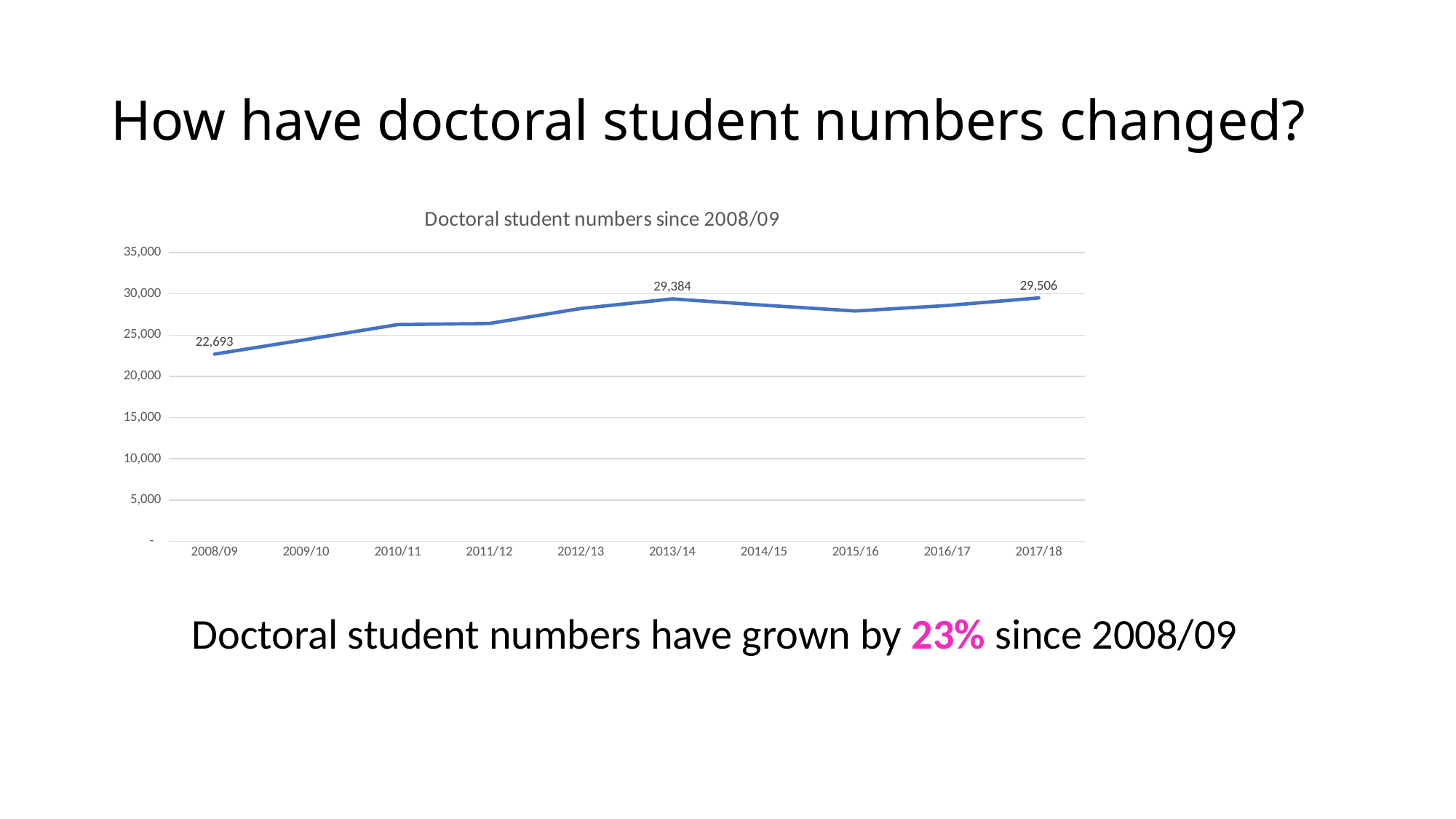
What is the doctoral student number for 2013/14? 29,384 What is the difference between the doctoral student numbers in 2017/18 and 2008/09? 6,813 What is the title of the chart? Doctoral student numbers since 2008/09 What kind of chart is shown on the slide? line chart Which year has the lowest doctoral student number? 2008/09 Is the doctoral student number for 2015/16 greater or less than 30,000? less How many academic years are plotted on the x axis? 10 What is the doctoral student number for 2017/18? 29,506 Do doctoral student numbers generally rise or fall from 2008/09 to 2017/18? rise What is the doctoral student number for 2008/09? 22,693 Which is larger, the doctoral student number in 2013/14 or in 2008/09? 2013/14 Is the doctoral student number for 2010/11 greater or less than 25,000? greater